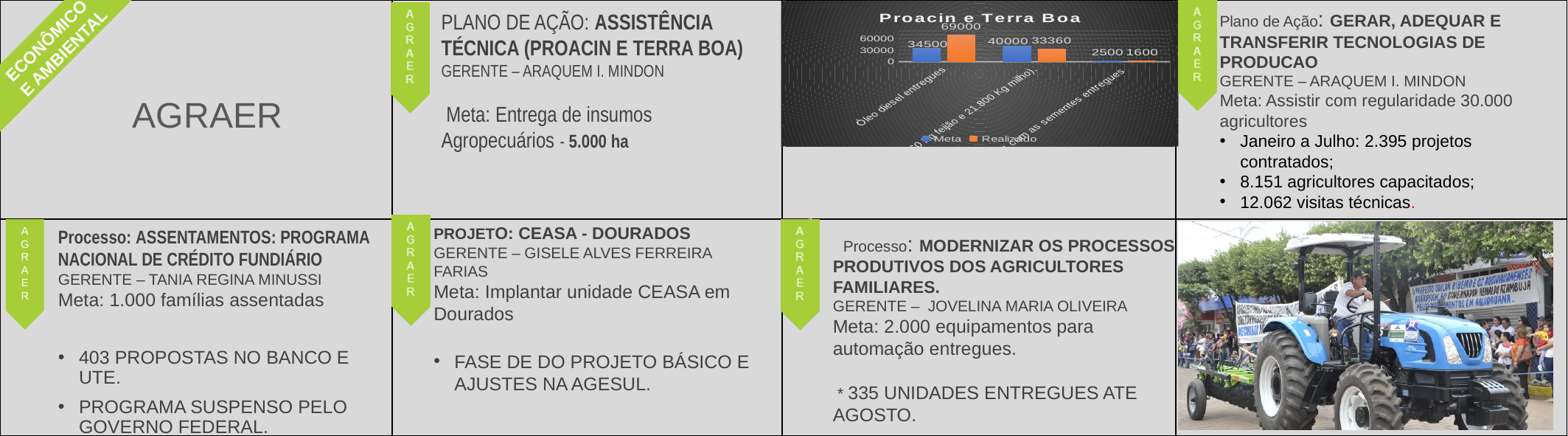
How many series does the legend of the chart list? 2 What are the two series named in the chart legend? Meta and Realizado What is the title of the chart on the slide? Proacin e Terra Boa What is the Realizado value for 'Óleo diesel entregues' in the chart? 69000 What is the difference between the Realizado and Meta values for 'Óleo diesel entregues'? 34500 Which category has the highest Realizado value in the chart? Óleo diesel entregues How many categories are plotted in the chart? 3 For 'Óleo diesel entregues', which is larger, the Meta or the Realizado value? Realizado What is the Meta value for 'Óleo diesel entregues' in the chart? 34500 What is the Meta value for the second category in the chart? 40000 Is the Realizado value for 'Óleo diesel entregues' greater or less than 60000? greater What kind of chart is shown on the slide? bar chart